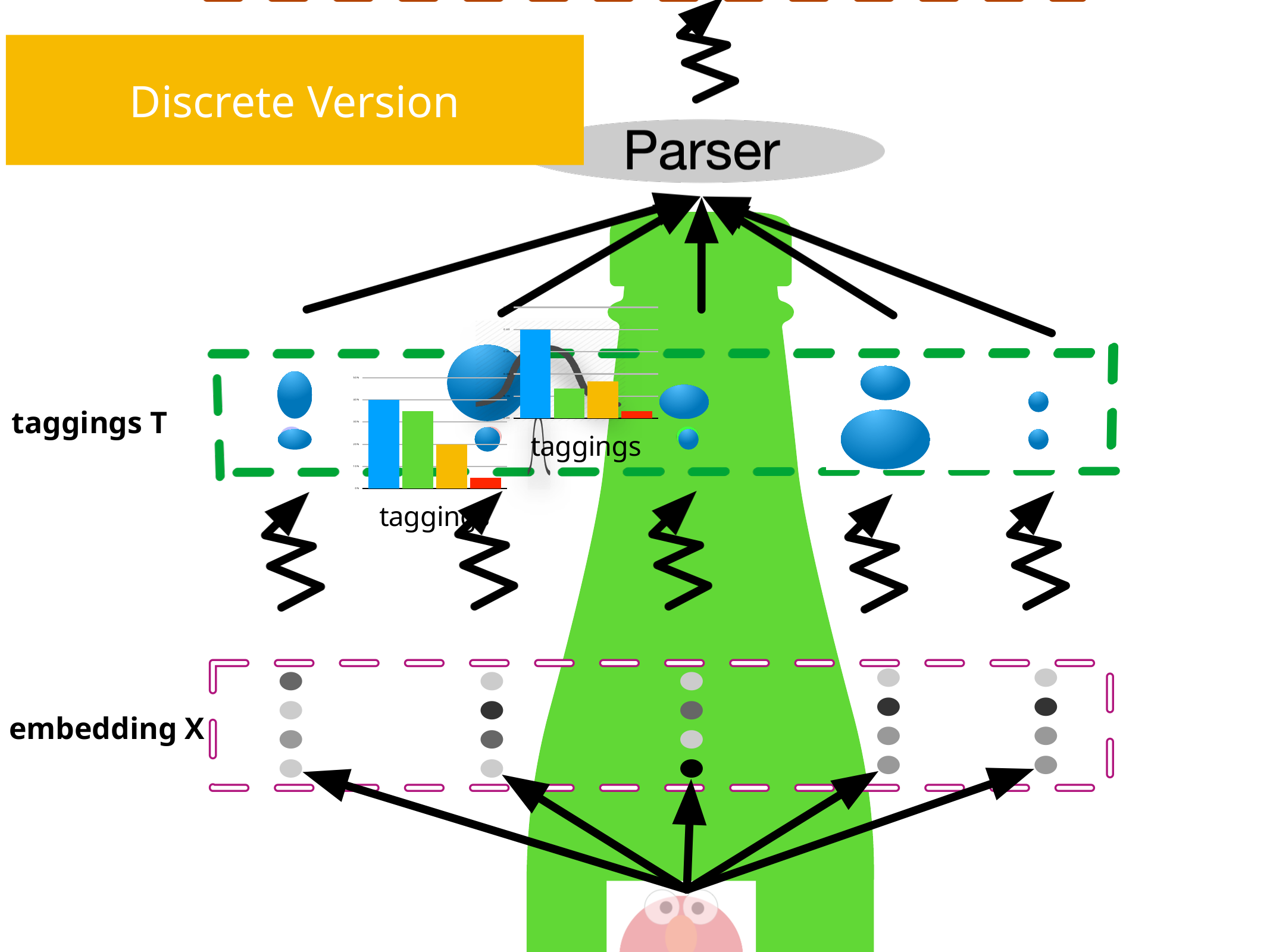
In the lower-left "taggings" bar chart, which coloured bar is the shortest? the red bar In the lower-left "taggings" bar chart, do the bar heights rise or fall from left to right? fall What kind of chart is the small chart labelled "taggings" at the lower left of the green dashed box? bar chart In the lower-left "taggings" bar chart, which coloured bar is the tallest? the blue bar In the lower-left "taggings" bar chart, which is taller, the green bar or the yellow bar? the green bar What label appears beneath each of the two small bar charts on the slide? taggings In the upper "taggings" bar chart near the centre of the green dashed box, which coloured bar is the tallest? the blue bar What are the four bar colours, from left to right, in the lower-left "taggings" bar chart? blue, green, yellow, red How many bars does the upper "taggings" bar chart (the one to the right, near the centre of the green dashed box) have? 4 How many bars does the lower-left "taggings" bar chart have? 4 In the upper "taggings" bar chart near the centre of the green dashed box, which coloured bar is the shortest? the red bar